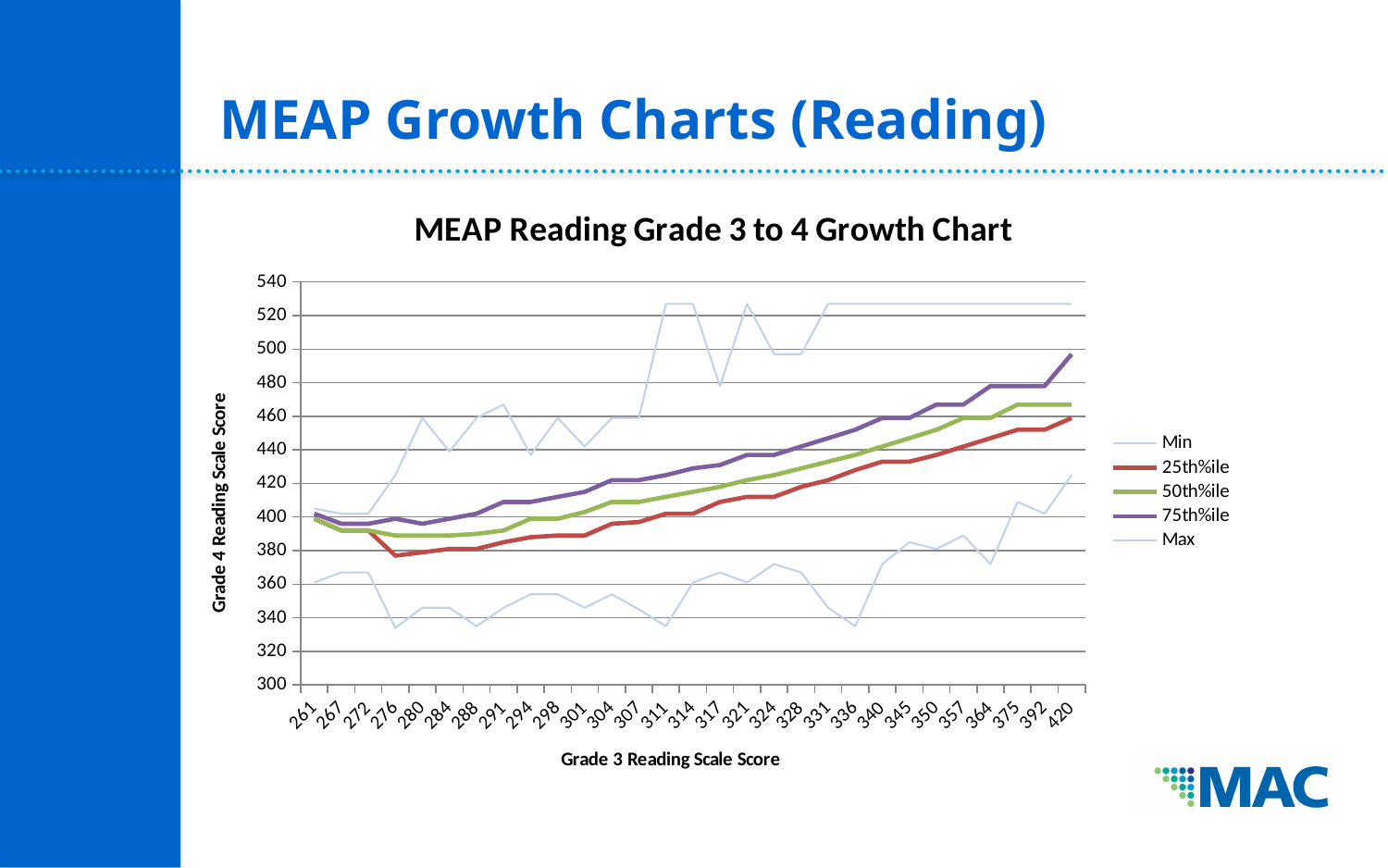
Is the Max value at a Grade 3 score of 311 greater or less than 520? greater How many series does the legend list? 5 At a Grade 3 score of 420, which is higher: the 75th%ile or the 25th%ile? 75th%ile What is the title of the chart? MEAP Reading Grade 3 to 4 Growth Chart How many Grade 3 Reading Scale Score categories are shown on the x axis? 29 Is the 50th%ile value at a Grade 3 score of 420 greater or less than 460? greater What is the label of the vertical axis? Grade 4 Reading Scale Score Is the Min value at a Grade 3 score of 276 greater or less than 340? less What kind of chart is shown on the slide? line chart Does the 75th%ile series generally rise or fall as the Grade 3 Reading Scale Score increases? rise